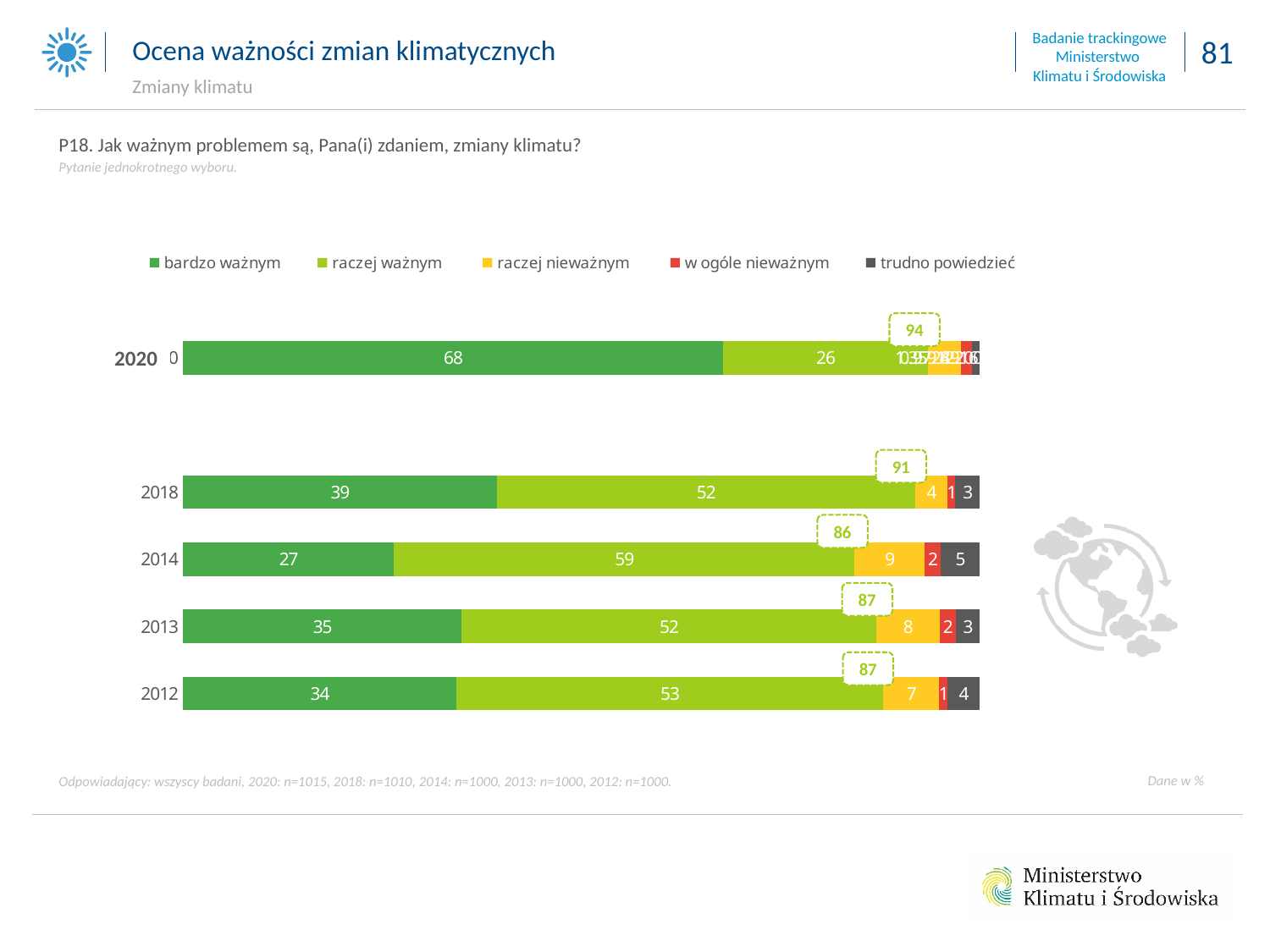
How many years (categories) are shown on the chart? 5 Which is larger: the 'raczej ważnym' value for 2012 or for 2013? 2012 What is the value for 'raczej ważnym' in 2014? 59 What is the combined value of 'bardzo ważnym' and 'raczej ważnym' shown above the 2014 bar? 86 What is the value for 'raczej nieważnym' in 2013? 8 What is the value for 'trudno powiedzieć' in 2012? 4 What kind of chart is shown on the slide? stacked bar chart How many series does the legend list? 5 What is the value for 'bardzo ważnym' in 2020? 68 What is the difference between the 'bardzo ważnym' values for 2020 and 2018? 29 Which year has the lowest value for 'bardzo ważnym'? 2014 Which year has the highest value for 'bardzo ważnym'? 2020